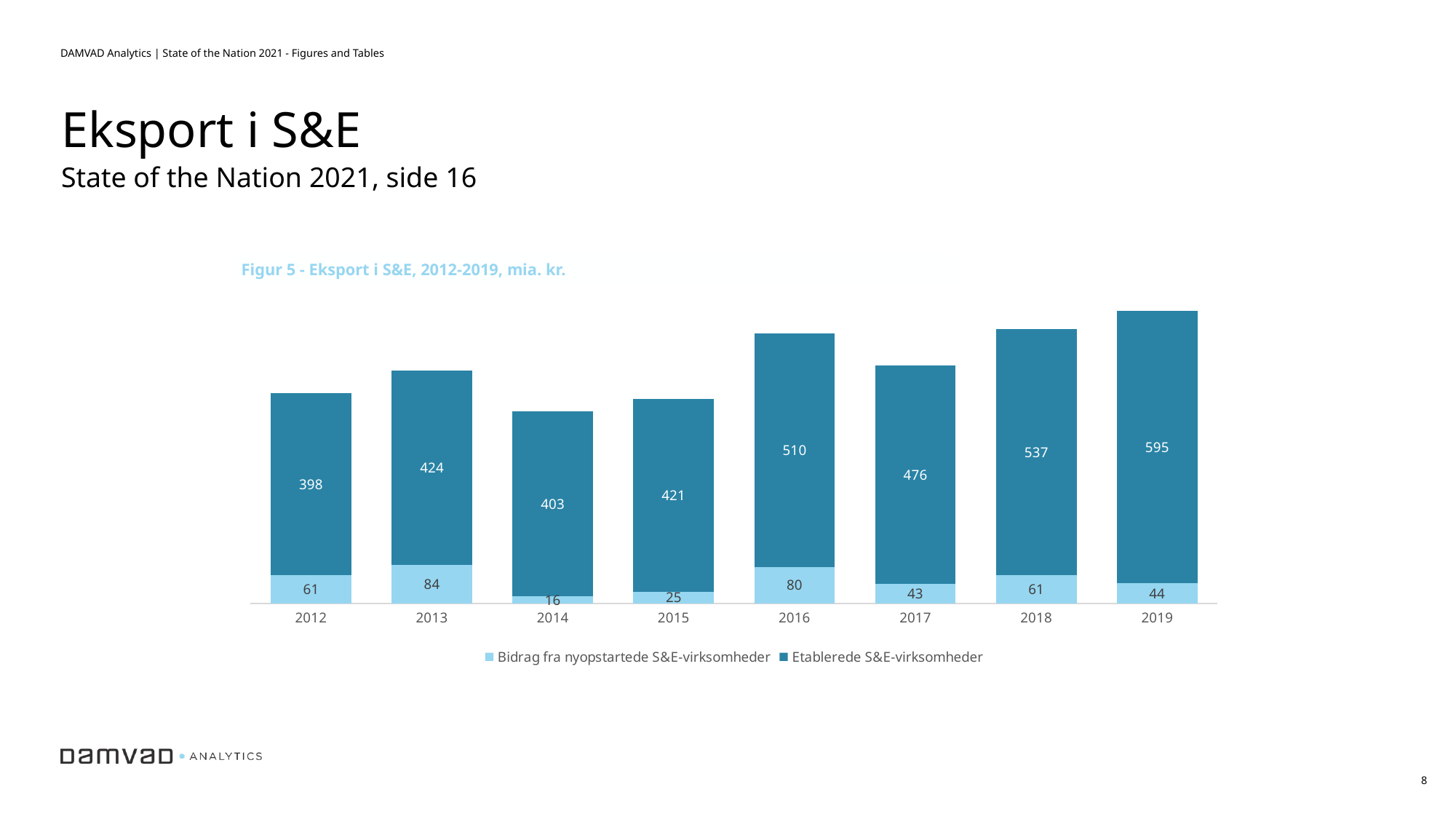
How many series does the legend list? 2 What is the title of the chart? Figur 5 - Eksport i S&E, 2012-2019, mia. kr. What kind of chart is shown on the slide? Stacked bar chart What is the difference between the Etablerede S&E-virksomheder values for 2019 and 2018? 58 In which year is the value for Bidrag fra nyopstartede S&E-virksomheder lowest? 2014 Which is larger: the Bidrag fra nyopstartede S&E-virksomheder value in 2016 or in 2017? 2016 What is the total of the stacked bar for 2019? 639 In which year is the value for Etablerede S&E-virksomheder highest? 2019 What is the total of the stacked bar for 2012? 459 How many years are shown on the x axis? 8 What is the value for Bidrag fra nyopstartede S&E-virksomheder in 2013? 84 What is the value for Etablerede S&E-virksomheder in 2016? 510